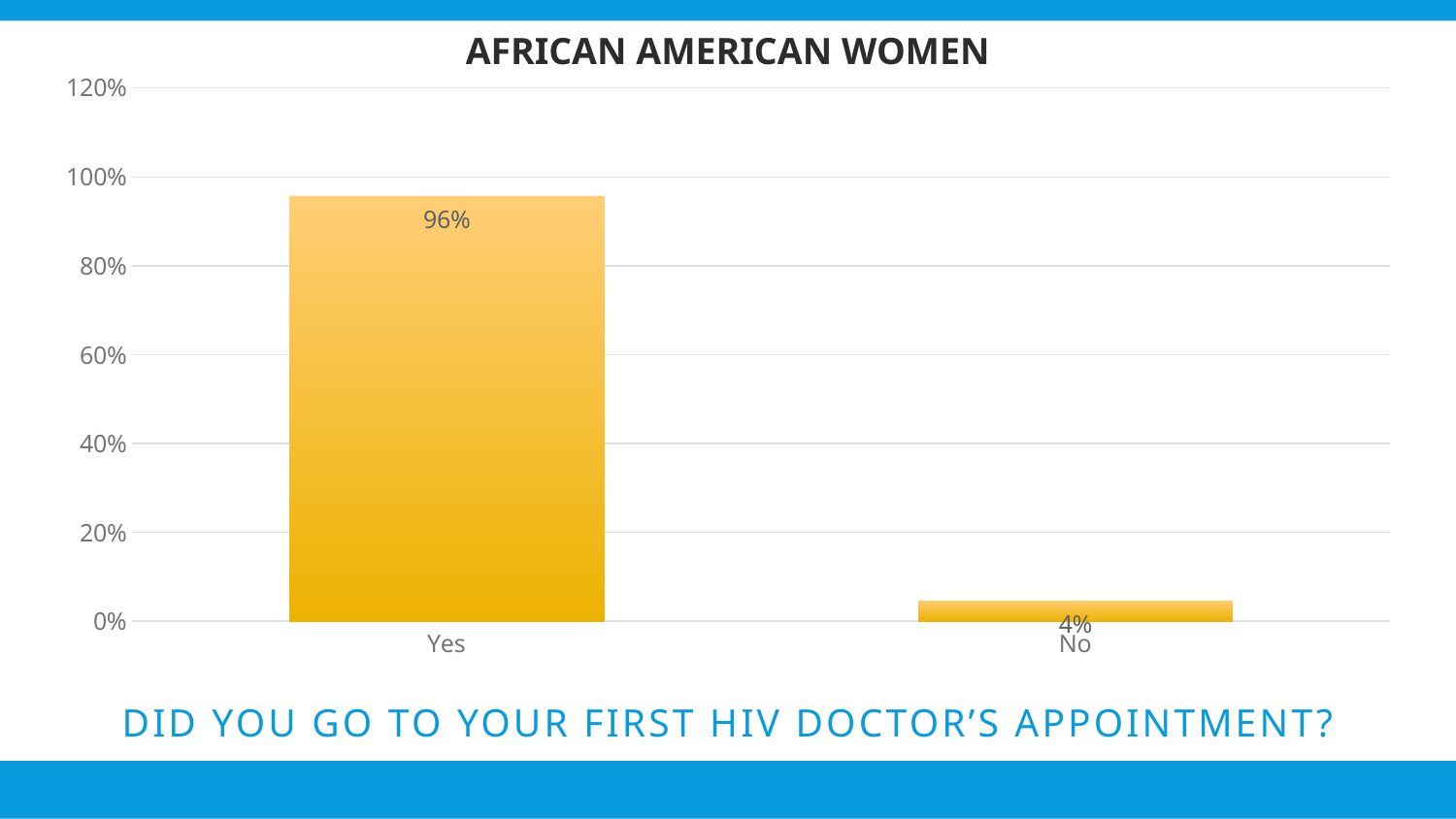
What is the highest value shown on the y axis? 120% Which category has the highest value? Yes Which is larger, the value for Yes or the value for No? Yes Is the value for Yes greater or less than 80%? greater How many categories are shown on the x axis? 2 Which category has the lowest value? No What is the value for No? 4% What kind of chart is shown on the slide? Bar chart Is the value for No greater or less than 20%? less What is the value for Yes? 96% What is the title of the chart? AFRICAN AMERICAN WOMEN What is the difference between the values for Yes and No? 92%